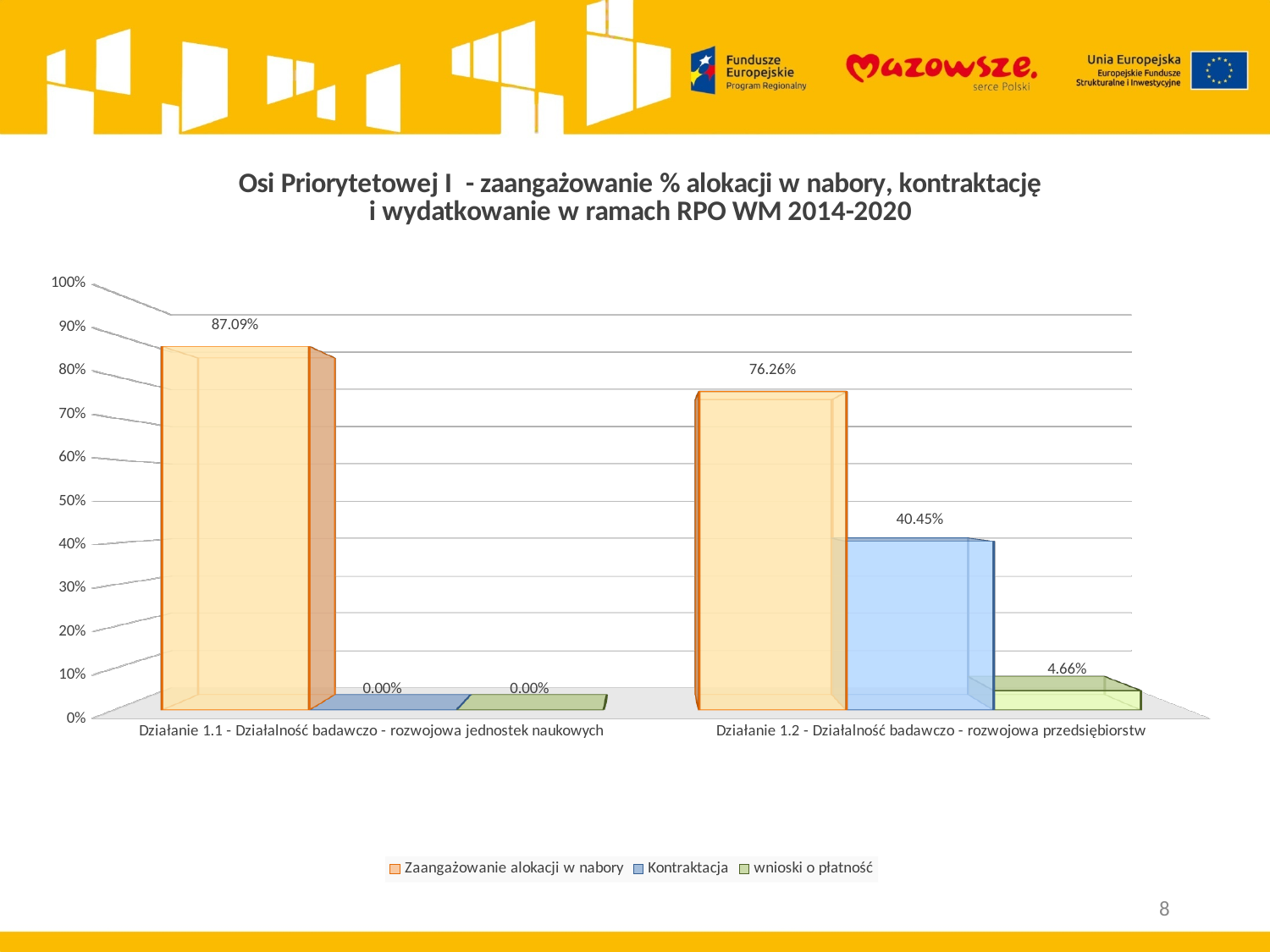
How many series does the legend list? 3 Which category has the higher value for 'Zaangażowanie alokacji w nabory'? Działanie 1.1 - Działalność badawczo - rozwojowa jednostek naukowych For Działanie 1.2, is 'Kontraktacja' or 'wnioski o płatność' larger? Kontraktacja What is the value of 'Kontraktacja' for Działanie 1.1? 0.00% What is the value of 'wnioski o płatność' for Działanie 1.2? 4.66% Which series is shown in blue in the legend? Kontraktacja What kind of chart is shown on the slide? Bar chart What is the value of 'Zaangażowanie alokacji w nabory' for Działanie 1.1? 87.09% For Działanie 1.2, what is the difference between 'Zaangażowanie alokacji w nabory' and 'Kontraktacja'? 35.81% What is the difference between 'Zaangażowanie alokacji w nabory' for Działanie 1.1 and Działanie 1.2? 10.83% How many categories are shown on the x axis? 2 What is the value of 'Kontraktacja' for Działanie 1.2? 40.45%